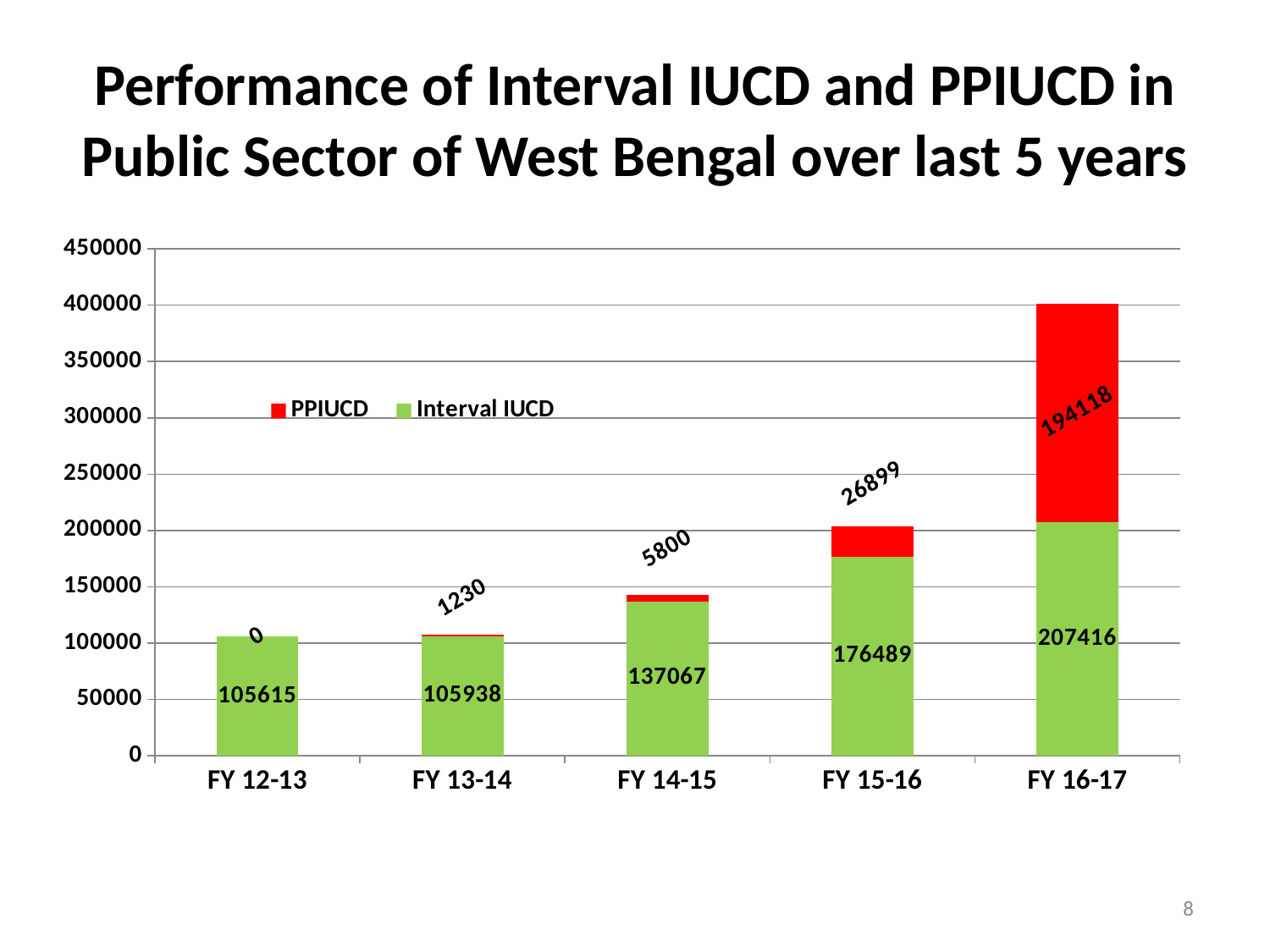
How many series does the legend list? 2 What is the PPIUCD value for FY 12-13? 0 Which fiscal year has the lowest Interval IUCD value? FY 12-13 How many fiscal years are shown on the x axis? 5 What is the difference between the Interval IUCD values for FY 16-17 and FY 15-16? 30927 Does the PPIUCD value rise or fall from FY 12-13 to FY 16-17? rise What is the Interval IUCD value for FY 16-17? 207416 Which fiscal year has the highest PPIUCD value? FY 16-17 What is the PPIUCD value for FY 15-16? 26899 What is the Interval IUCD value for FY 14-15? 137067 What is the total of the stacked bar for FY 16-17? 401534 Which is larger: the PPIUCD value for FY 14-15 or the PPIUCD value for FY 13-14? PPIUCD value for FY 14-15